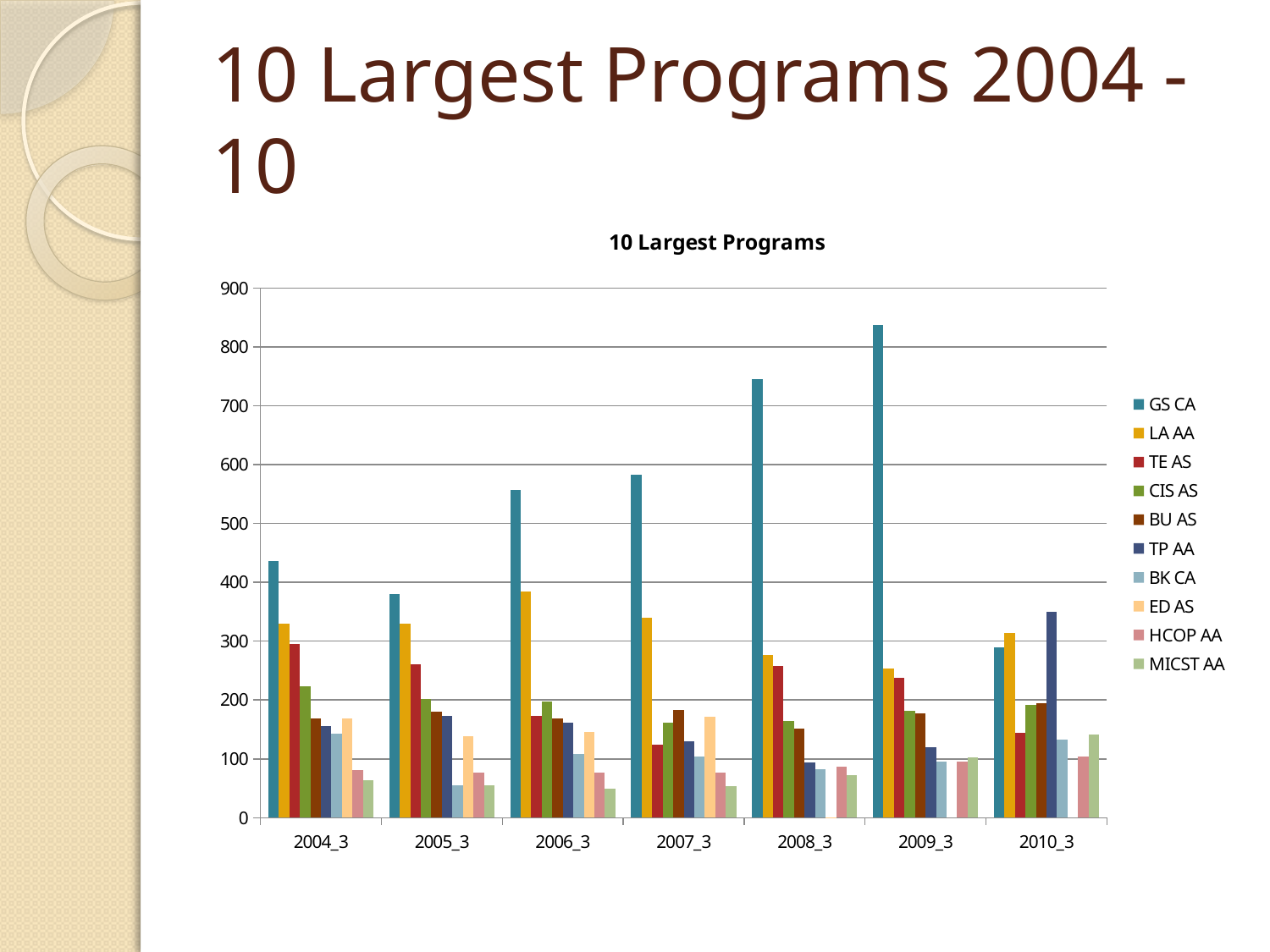
In which year is the GS CA value highest? 2009_3 How many series does the legend list? 10 Is the value for LA AA in 2006_3 greater or less than 300? greater In which year is the GS CA value lowest? 2010_3 What kind of chart is shown on the slide? bar chart Is the value for GS CA in 2010_3 greater or less than 400? less How many year categories are shown on the x axis? 7 What is the title of the chart? 10 Largest Programs Is the value for TE AS in 2007_3 greater or less than 200? less In 2010_3, which is larger: GS CA or TP AA? TP AA Does the GS CA value rise or fall from 2005_3 to 2009_3? rise